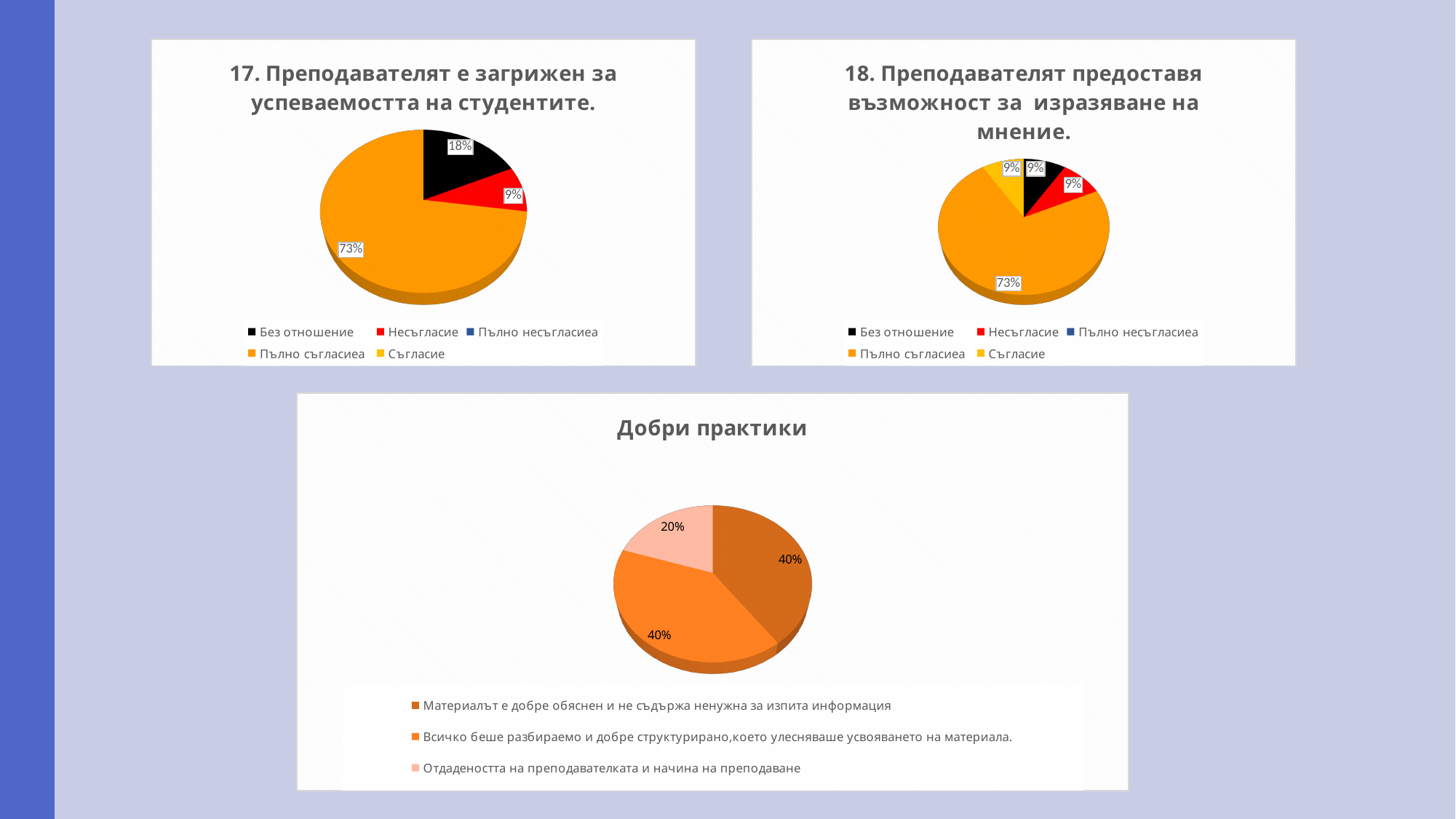
In the chart titled "17. Преподавателят е загрижен за успеваемостта на студентите.", which category has the largest slice? Пълно съгласиеа What kind of chart is the one titled "Добри практики"? Pie chart In the chart titled "Добри практики", what share does "Отдадеността на преподавателката и начина на преподаване" have? 20% How many entries does the legend list in the chart titled "18. Преподавателят предоставя възможност за изразяване на мнение."? 5 In the chart titled "17. Преподавателят е загрижен за успеваемостта на студентите.", what share does "Пълно съгласиеа" have? 73% How many slices does the chart titled "Добри практики" have? 3 In the chart titled "18. Преподавателят предоставя възможност за изразяване на мнение.", what share does "Пълно съгласиеа" have? 73% In the chart titled "17. Преподавателят е загрижен за успеваемостта на студентите.", what share does "Без отношение" have? 18% In the chart titled "Добри практики", which category has the smallest slice? Отдадеността на преподавателката и начина на преподаване In the chart titled "18. Преподавателят предоставя възможност за изразяване на мнение.", what share does "Съгласие" have? 9% In the chart titled "Добри практики", is the share for "Материалът е добре обяснен и не съдържа ненужна за изпита информация" larger or smaller than the share for "Отдадеността на преподавателката и начина на преподаване"? Larger In the chart titled "17. Преподавателят е загрижен за успеваемостта на студентите.", what is the difference between the "Без отношение" and "Несъгласие" shares? 9%